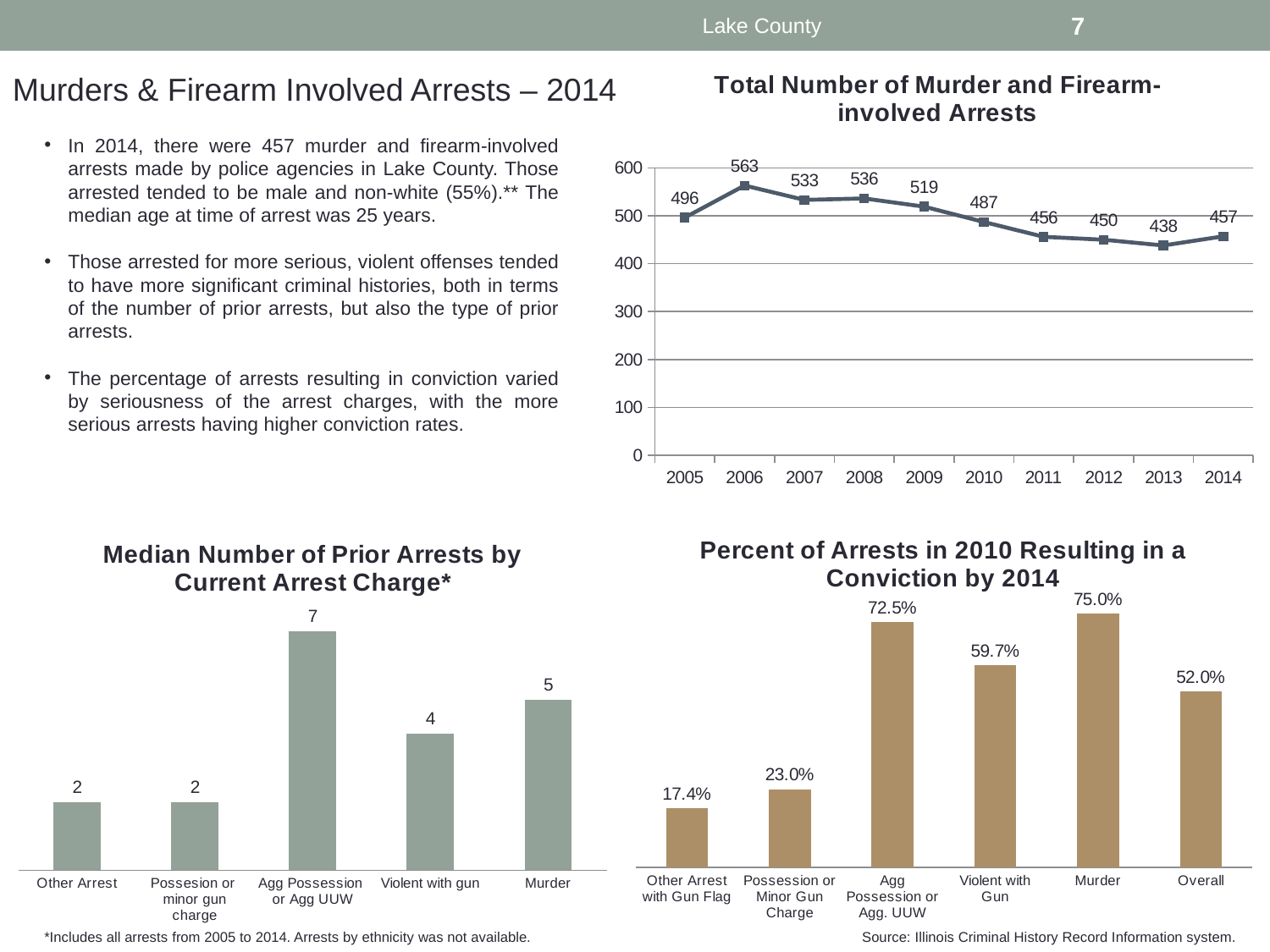
In the 'Total Number of Murder and Firearm-involved Arrests' chart, what is the difference between the 2006 value and the 2014 value? 106 In the 'Total Number of Murder and Firearm-involved Arrests' chart, what was the value for 2006? 563 In the 'Percent of Arrests in 2010 Resulting in a Conviction by 2014' chart, what is the difference between Murder and Overall? 23.0% What type of chart is 'Total Number of Murder and Firearm-involved Arrests'? Line chart In the 'Percent of Arrests in 2010 Resulting in a Conviction by 2014' chart, what is the value for Violent with Gun? 59.7% In the 'Total Number of Murder and Firearm-involved Arrests' chart, which year had the lowest number of arrests? 2013 How many categories are shown in the 'Percent of Arrests in 2010 Resulting in a Conviction by 2014' chart? 6 In the 'Median Number of Prior Arrests by Current Arrest Charge*' chart, which category has the highest value? Agg Possession or Agg UUW In the 'Percent of Arrests in 2010 Resulting in a Conviction by 2014' chart, which category has the lowest value? Other Arrest with Gun Flag In the 'Median Number of Prior Arrests by Current Arrest Charge*' chart, which is larger: Violent with gun or Murder? Murder In the 'Total Number of Murder and Firearm-involved Arrests' chart, how many years are plotted? 10 In the 'Median Number of Prior Arrests by Current Arrest Charge*' chart, what is the value for Murder? 5